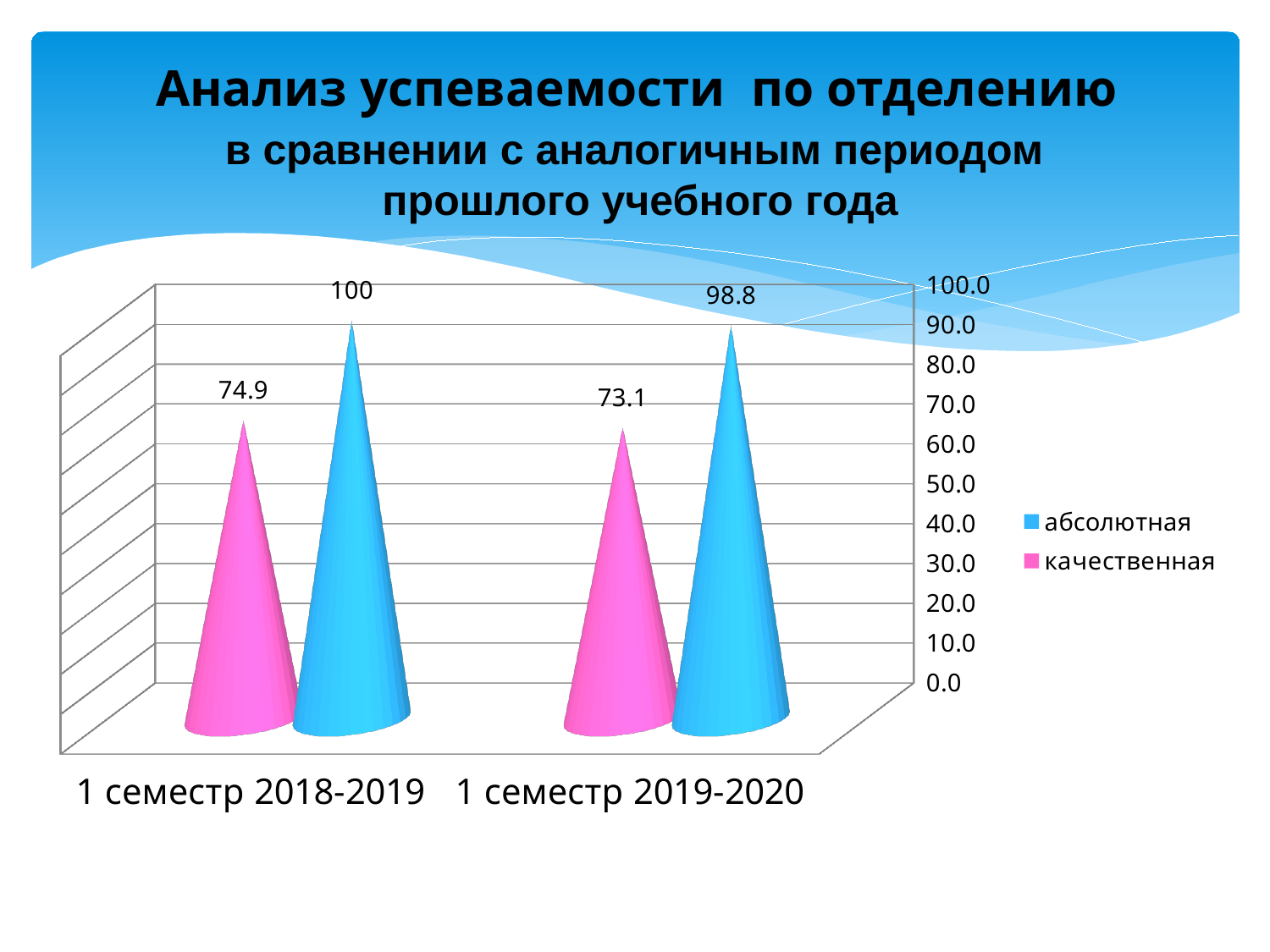
What is the value of абсолютная for 1 семестр 2018-2019? 100 What is the value of абсолютная for 1 семестр 2019-2020? 98.8 Which is larger for 1 семестр 2019-2020: абсолютная or качественная? абсолютная What is the difference between the качественная values for 1 семестр 2018-2019 and 1 семестр 2019-2020? 1.8 How many series does the legend list? 2 What is the value of качественная for 1 семестр 2018-2019? 74.9 What is the value of качественная for 1 семестр 2019-2020? 73.1 Which category has the highest value for качественная? 1 семестр 2018-2019 What kind of chart is shown on the slide? bar chart Which colour represents the series качественная in the legend? pink How many categories are shown on the x axis? 2 Which category has the lowest value for абсолютная? 1 семестр 2019-2020